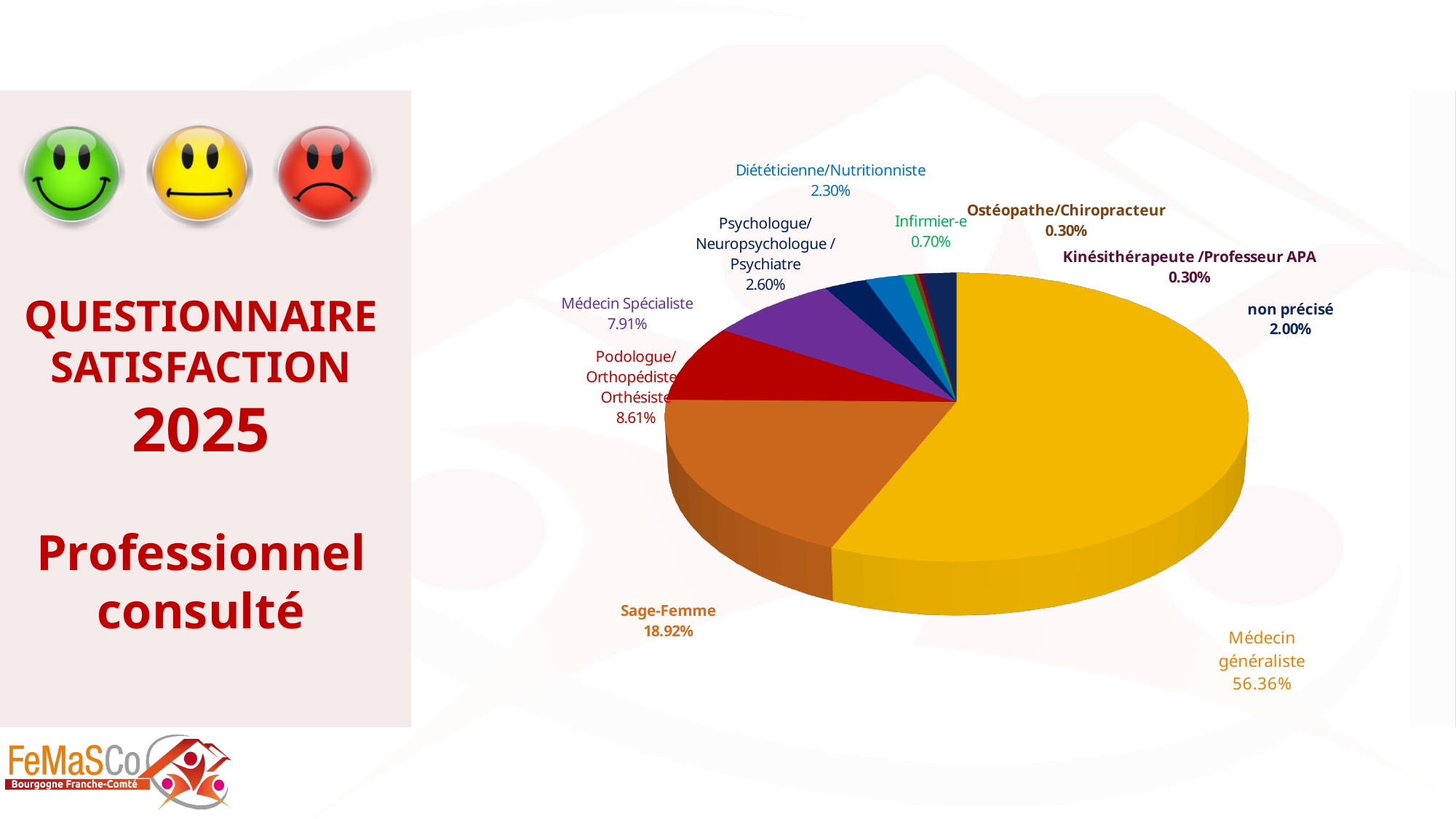
What is the difference between the Médecin généraliste share and the Sage-Femme share? 37.44% Which category has the largest slice of the pie? Médecin généraliste What colour is the Médecin généraliste slice? Yellow How many categories are shown in the pie chart? 10 What kind of chart is shown on the slide? Pie chart What percentage is labelled for 'non précisé'? 2.00% What percentage is shown for Médecin Spécialiste? 7.91% What is the difference between the Sage-Femme share and the Podologue/Orthopédiste Orthésiste share? 10.31% What is the value for Infirmier-e? 0.70% Which is larger, the share for Podologue/Orthopédiste Orthésiste or for Médecin Spécialiste? Podologue/Orthopédiste Orthésiste What is the value shown for Sage-Femme? 18.92% What share of the pie does Médecin généraliste represent? 56.36%